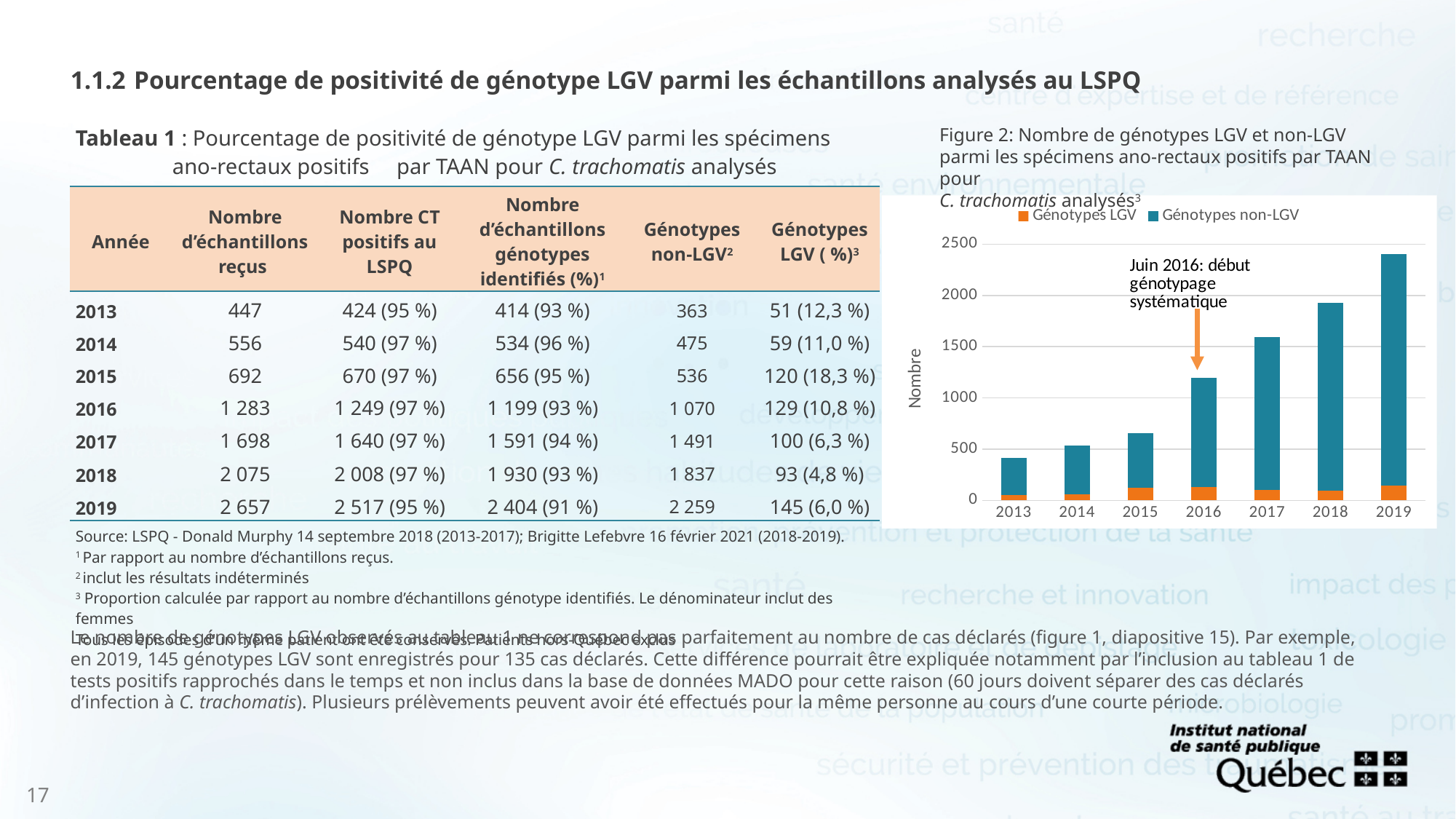
In Figure 2, which year has the shortest stacked bar? 2013 In Figure 2, is the total bar height for 2016 greater or less than 1000? greater In Figure 2, which year has the taller stacked bar, 2017 or 2018? 2018 In Figure 2, is the total bar height for 2018 greater or less than 2000? less What kind of chart is Figure 2? Stacked bar chart In Figure 2, is the total bar height for 2019 greater or less than 2000? greater In Figure 2, which year has the tallest stacked bar? 2019 How many years are shown on the x axis of Figure 2? 7 How many series does the legend of Figure 2 list? 2 In Figure 2, which series is shown in orange? Génotypes LGV In Figure 2, do the total bar heights rise or fall from 2013 to 2019? Rise